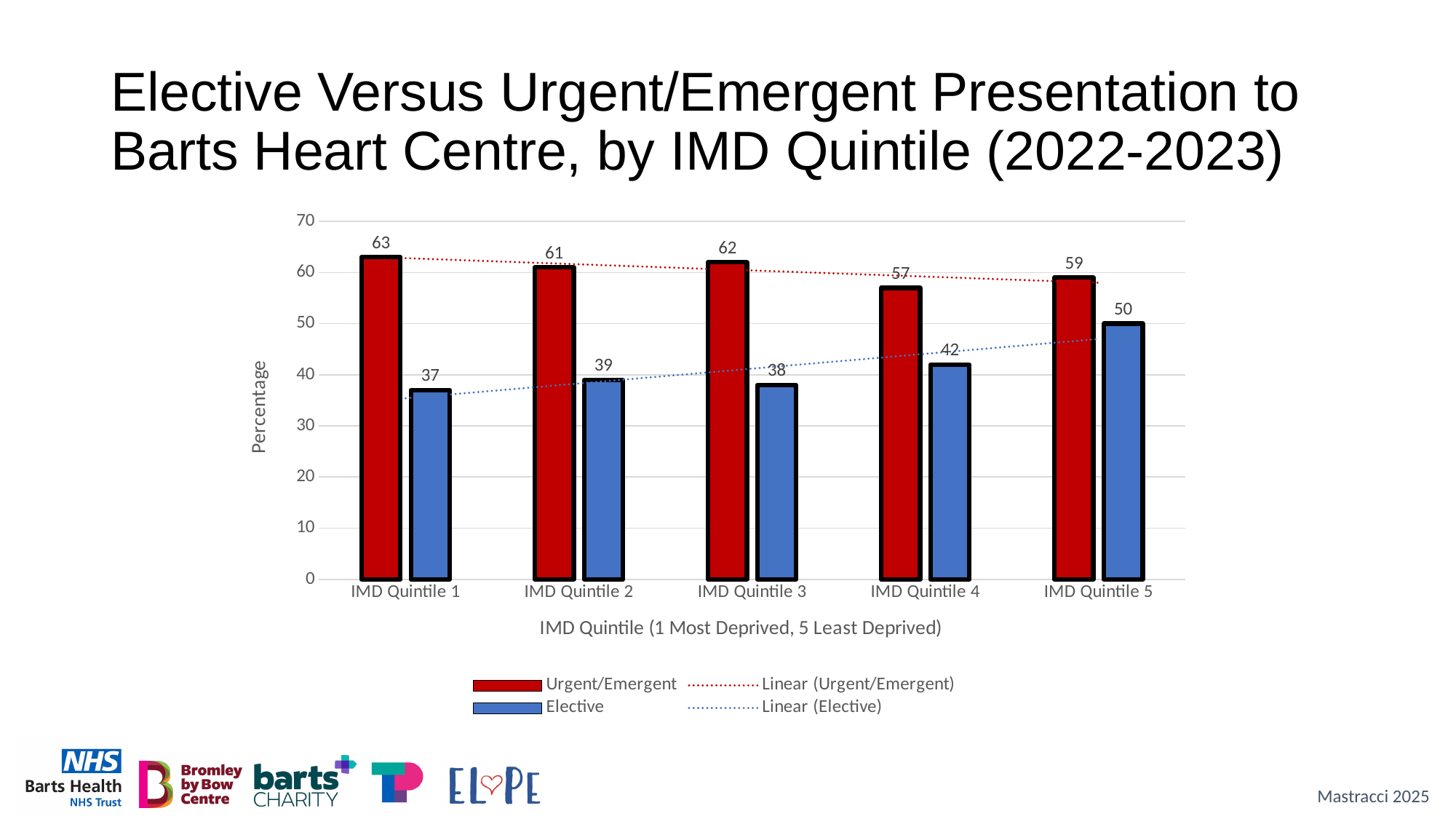
What is the Elective value for IMD Quintile 3? 38 Do the Elective values generally rise or fall from IMD Quintile 1 to IMD Quintile 5? Rise Which IMD quintile has the highest Urgent/Emergent value? IMD Quintile 1 What kind of chart is shown on the slide? Bar chart What is the difference between the Urgent/Emergent and Elective values for IMD Quintile 4? 15 How many entries does the legend list? 4 What is the Urgent/Emergent value for IMD Quintile 1? 63 What is the Elective value for IMD Quintile 5? 50 Which is larger for IMD Quintile 2: the Urgent/Emergent value or the Elective value? Urgent/Emergent Which IMD quintile has the lowest Elective value? IMD Quintile 1 What is the label of the y axis? Percentage How many IMD quintile categories are shown on the x axis? 5